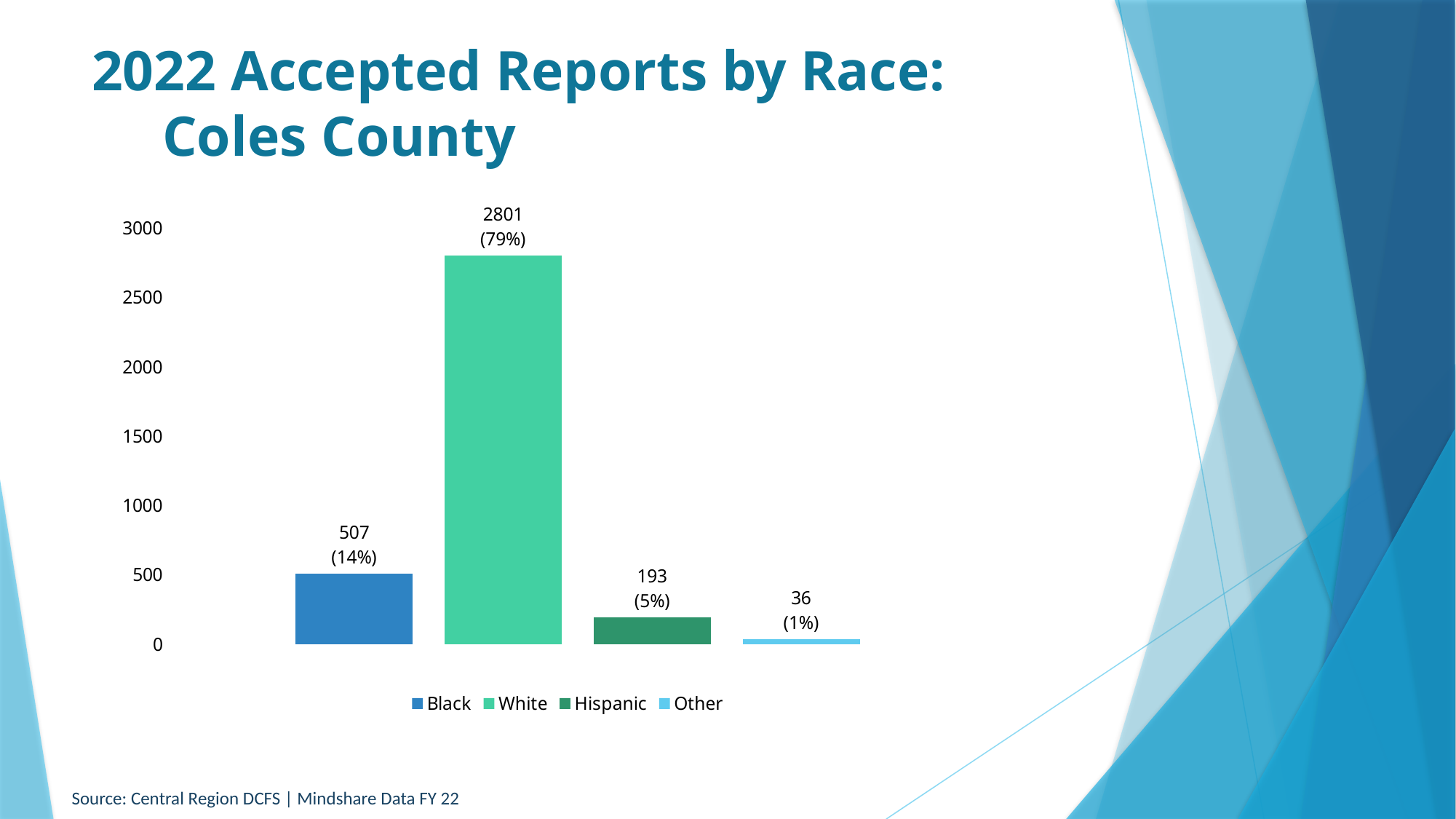
Which has more accepted reports, Black or Hispanic? Black How many accepted reports are shown for Black? 507 What percentage is shown for Hispanic? 5% Which race category has the highest number of accepted reports? White How many race categories are shown in the chart? 4 Is the value for Black greater or less than 1000? less How many accepted reports are shown for White? 2801 How many accepted reports are shown for Other? 36 What is the difference between the number of accepted reports for White and for Black? 2294 Which race category has the lowest number of accepted reports? Other What kind of chart is shown on the slide? Bar chart What is the source cited at the bottom of the slide? Central Region DCFS | Mindshare Data FY 22